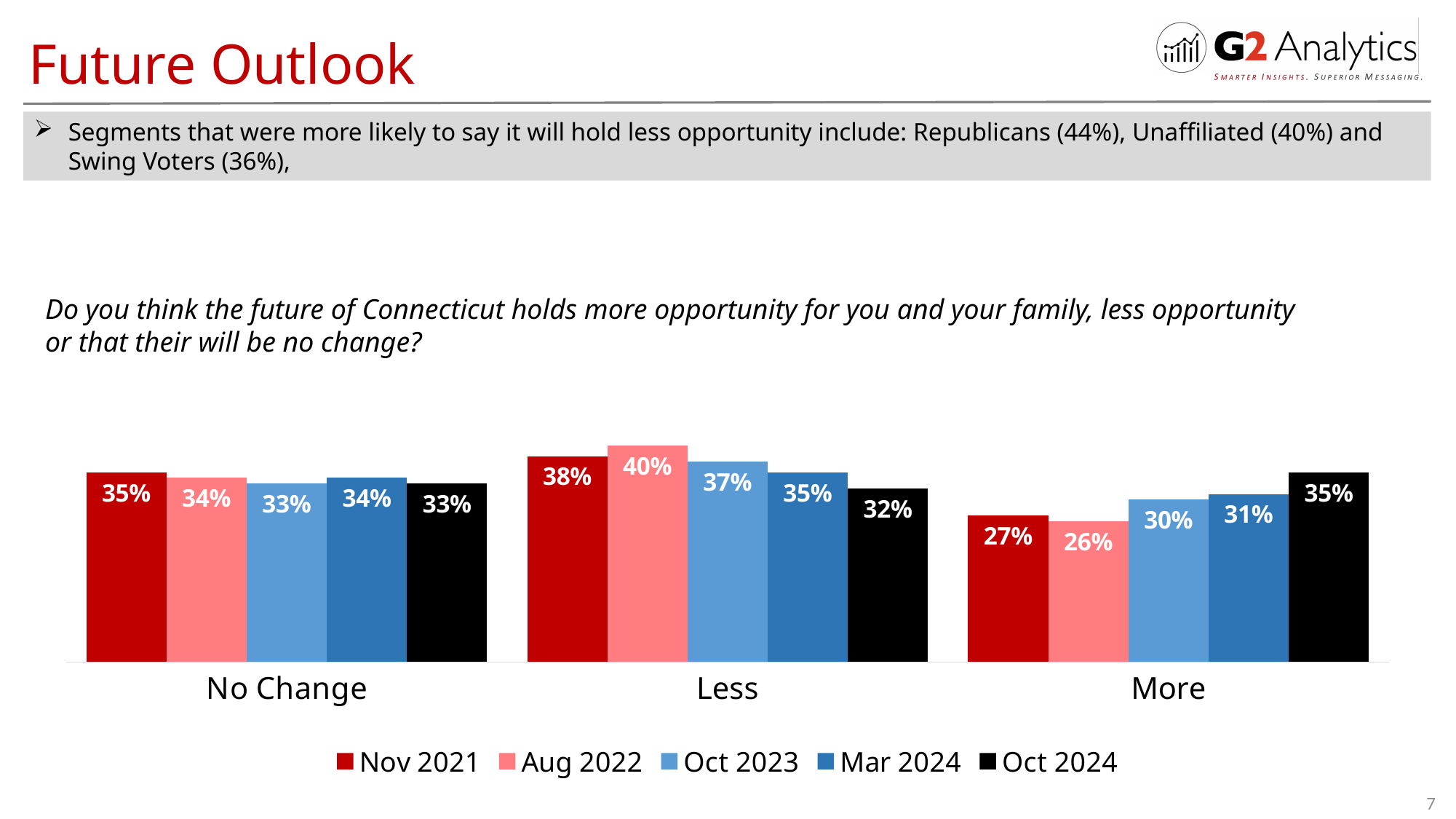
What kind of chart is shown on the slide? Bar chart How many response categories are shown on the x axis? 3 Which colour represents Oct 2024 in the legend? Black Which is larger for Oct 2024: "Less" or "More"? More What is the Nov 2021 value for "No Change"? 35% Which survey wave has the highest value for "Less"? Aug 2022 What is the difference between the Oct 2024 and Nov 2021 values for "More"? 8% What is the Oct 2024 value for "More"? 35% What percentage said "Less" in Aug 2022? 40% What is the difference between the Aug 2022 and Oct 2024 values for "Less"? 8% How many series does the legend list? 5 Which survey wave has the lowest value for "More"? Aug 2022